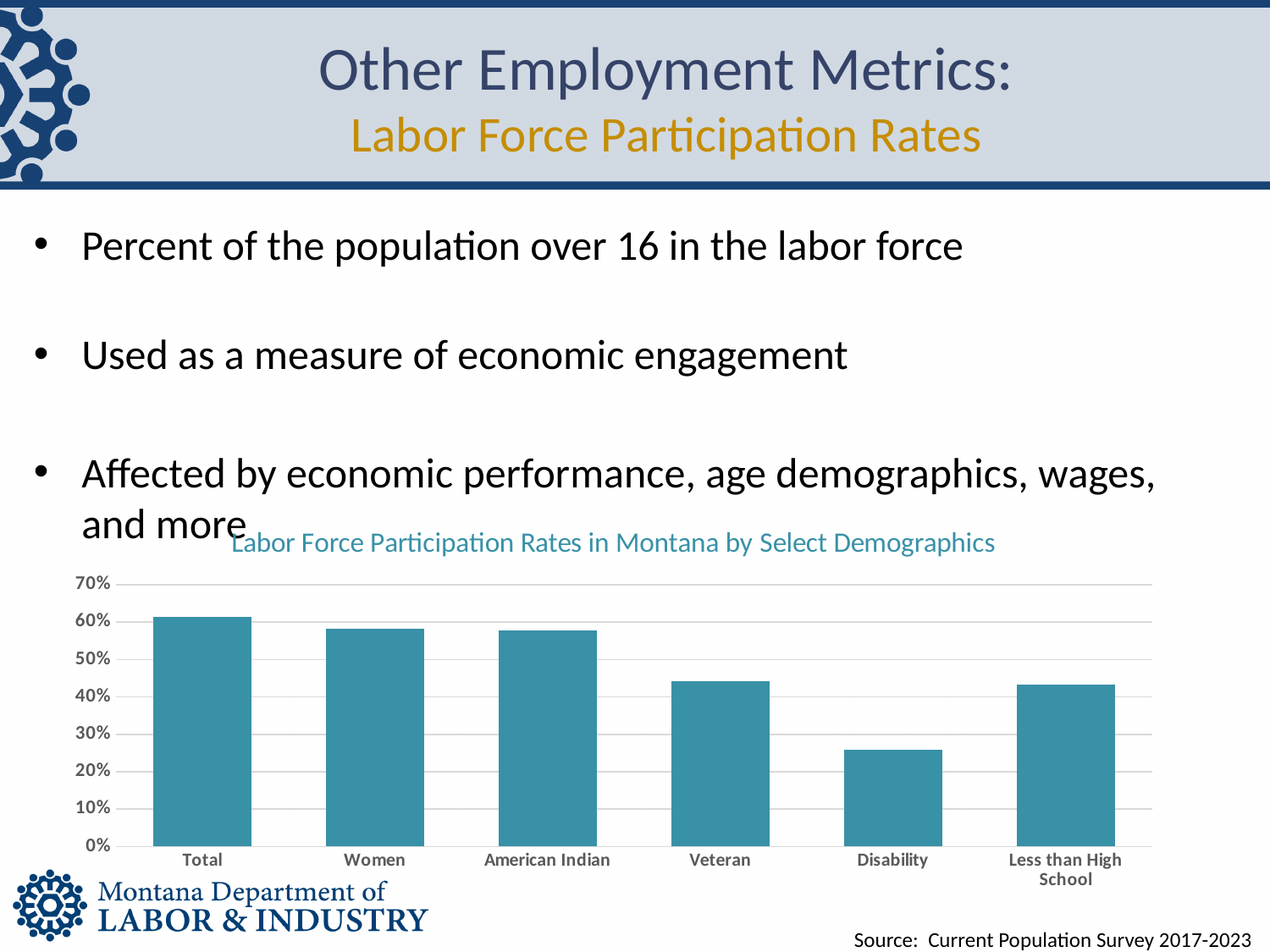
Which is larger, the value for Disability or the value for Less than High School? Less than High School Is the value for Total greater or less than 50%? greater What is the title of the chart? Labor Force Participation Rates in Montana by Select Demographics Is the value for Disability greater or less than 30%? less Which category has the highest labor force participation rate? Total Is the value for Women greater or less than 50%? greater Which category has the lowest labor force participation rate? Disability How many demographic categories are shown in the chart? 6 Which is larger, the value for Women or the value for Veteran? Women What type of chart is shown on the slide? bar chart